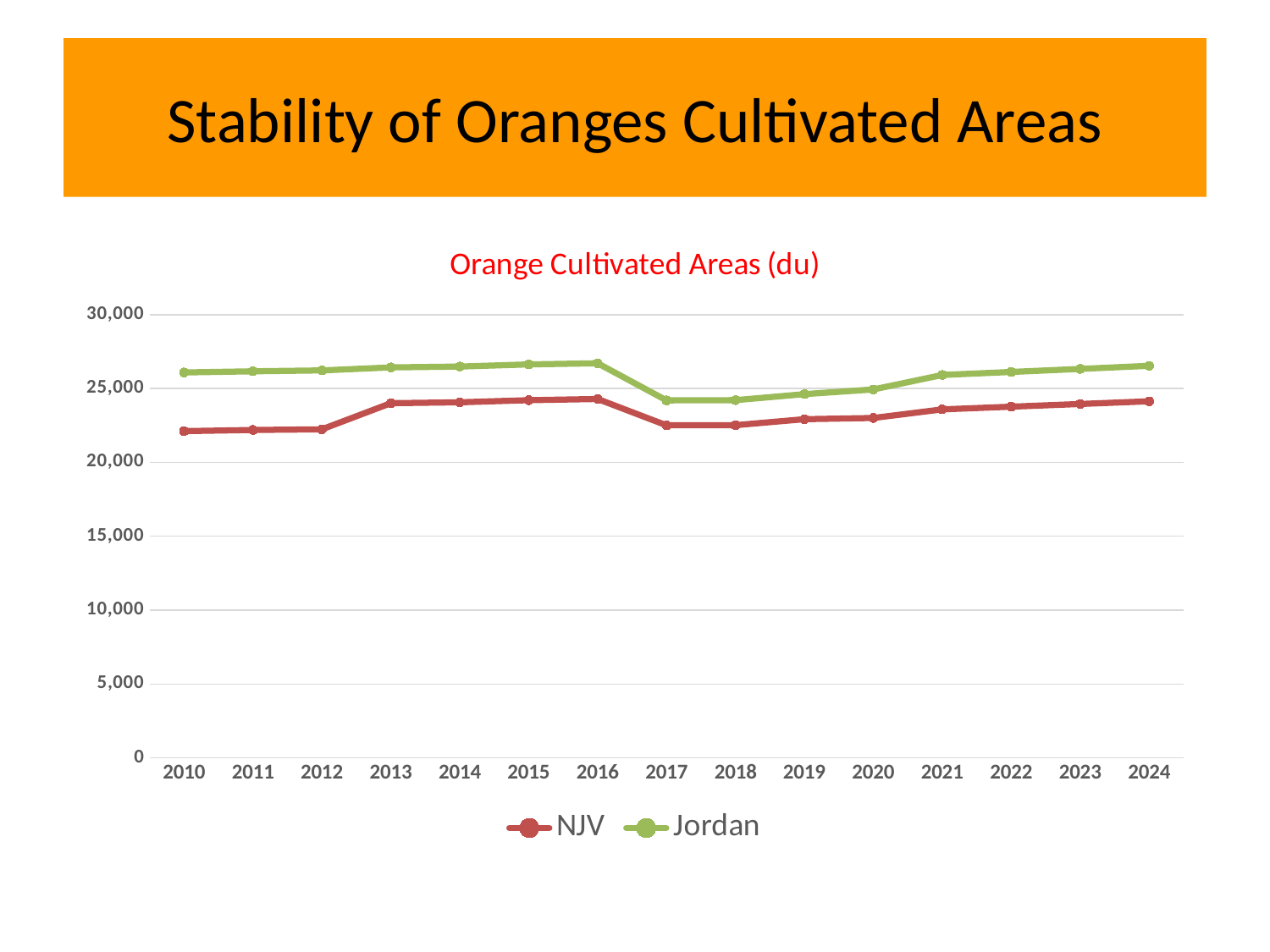
Is the value for Jordan in 2017 greater or less than 25,000? less What kind of chart is shown on the slide? line chart Is the value for NJV in 2010 greater or less than 25,000? less How many years are plotted along the x axis? 15 In 2020, which series has the larger value, NJV or Jordan? Jordan In 2016, which series has the larger value, NJV or Jordan? Jordan What is the title of the chart? Orange Cultivated Areas (du) Is the value for Jordan in 2010 greater or less than 25,000? greater How many series does the legend list? 2 Which series is drawn in green? Jordan